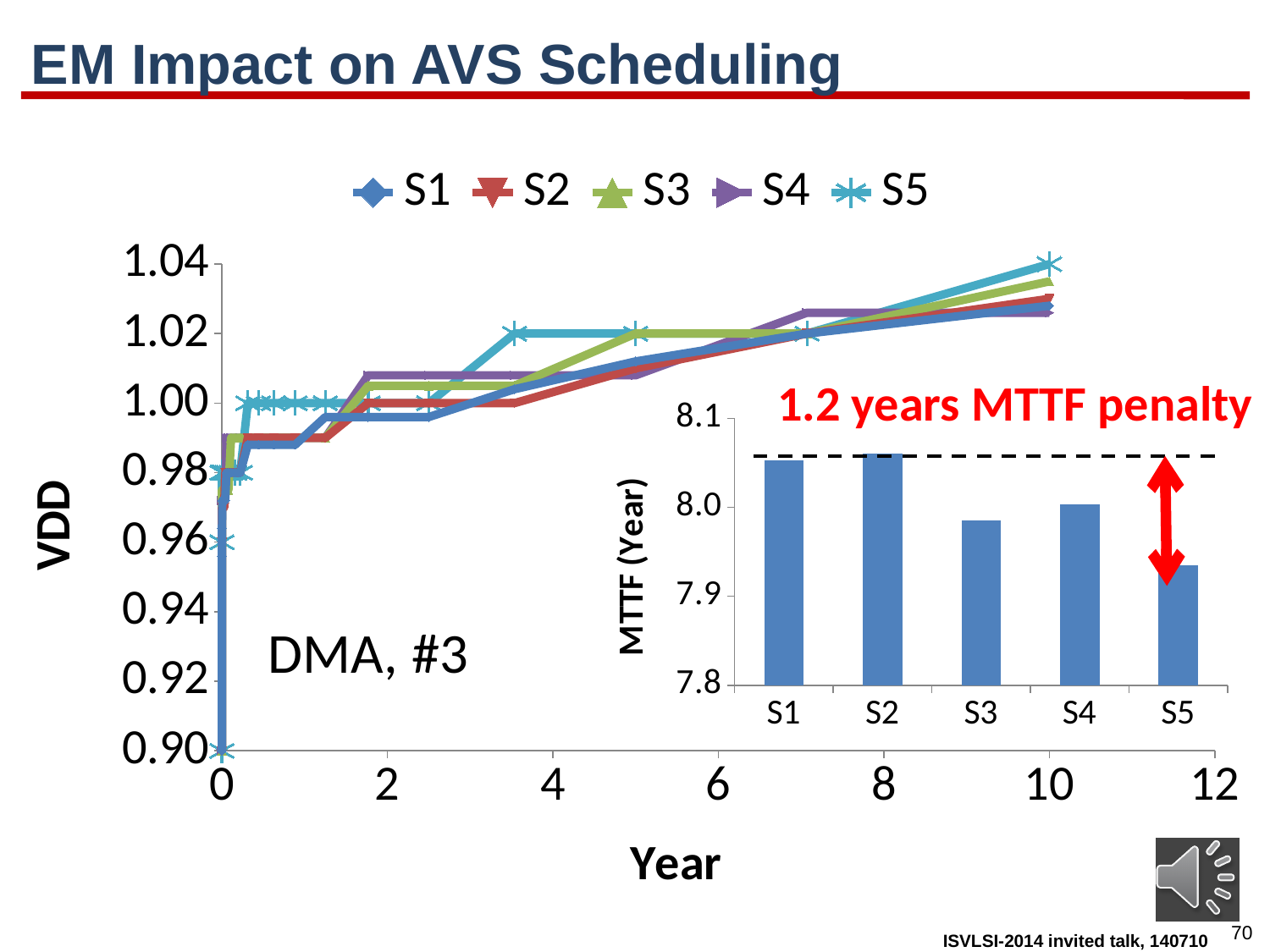
In the inset bar chart, is the MTTF for S5 greater or less than 8.0 years? less In the inset bar chart, which has the larger MTTF, S1 or S5? S1 In the VDD versus Year line chart, does VDD generally rise or fall as Year increases? rise How many scheduling schemes are shown on the x axis of the inset MTTF bar chart? 5 In the inset bar chart, which scheduling scheme has the lowest MTTF? S5 What kind of chart is the large VDD versus Year chart? line chart In the VDD versus Year line chart, is the VDD value for S5 at year 10 greater or less than 1.02? greater In the inset bar chart, which scheduling scheme has the highest MTTF? S2 In the inset bar chart, is the MTTF for S1 greater or less than 8.0 years? greater What MTTF penalty does the red annotation on the inset bar chart state? 1.2 years MTTF penalty How many series does the legend of the VDD versus Year line chart list? 5 What kind of chart is the inset MTTF chart? bar chart